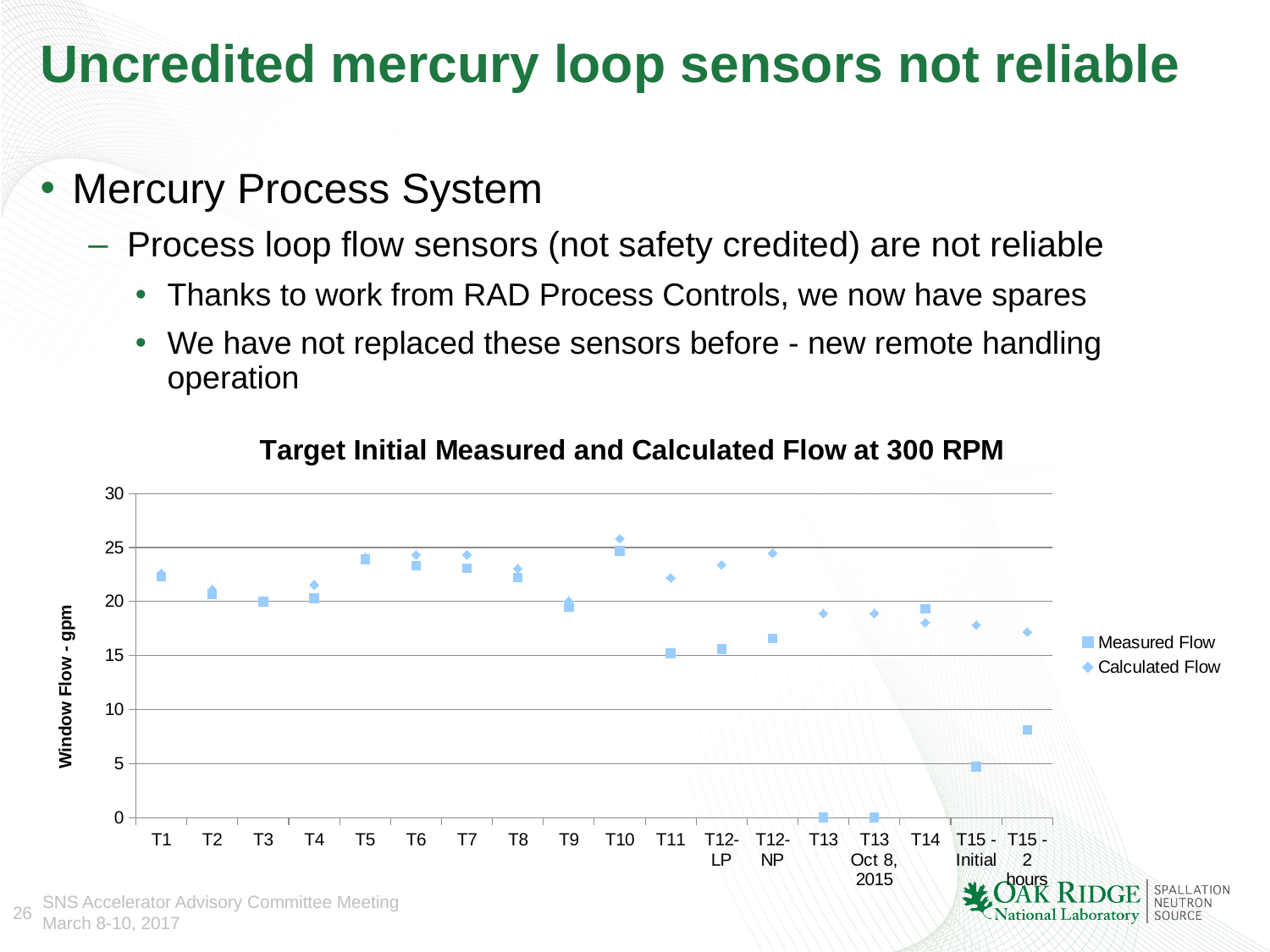
At T11, which is larger: the Measured Flow or the Calculated Flow? Calculated Flow What is the title of the chart? Target Initial Measured and Calculated Flow at 300 RPM Which category has the highest Calculated Flow value? T10 What kind of chart is shown on the slide? scatter chart What is the label of the y axis of the chart? Window Flow - gpm How many target categories are shown along the x axis of the chart? 18 Is the Measured Flow value for T5 greater or less than 20? greater Is the Calculated Flow value for T14 greater or less than 20? less Is the Measured Flow value for T15 - 2 hours greater or less than 10? less Does the Measured Flow rise or fall from T10 to T13? fall How many series does the chart legend list? 2